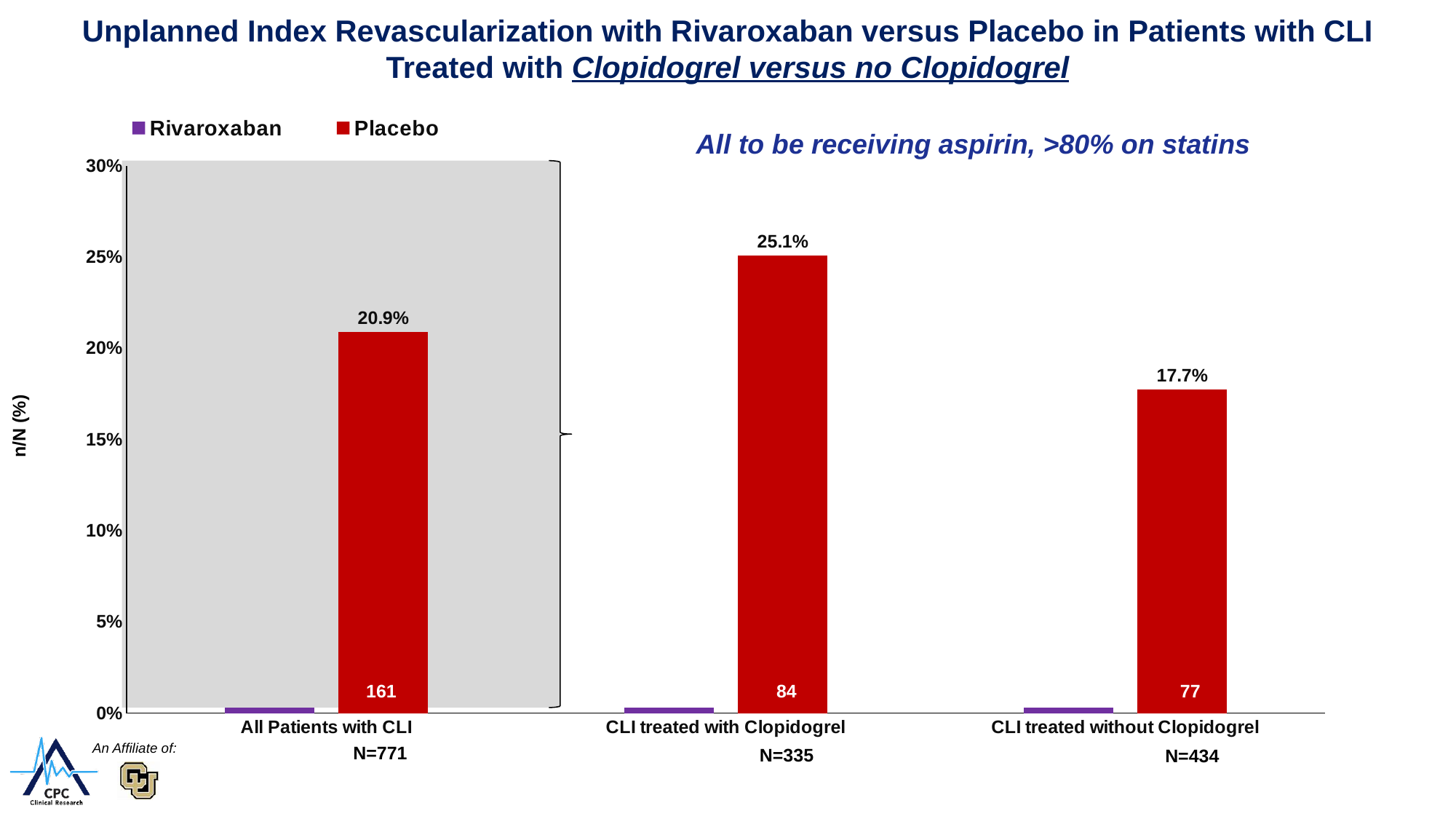
What is the Placebo value for All Patients with CLI? 20.9% What is the Placebo value for CLI treated with Clopidogrel? 25.1% What is the difference between the Placebo values for CLI treated with Clopidogrel and CLI treated without Clopidogrel? 7.4 percentage points What is the number of events (n) shown inside the Placebo bar for All Patients with CLI? 161 Which category has the lowest Placebo value? CLI treated without Clopidogrel Which category has the highest Placebo value? CLI treated with Clopidogrel How many categories are shown on the x axis? 3 What is the Placebo value for CLI treated without Clopidogrel? 17.7% What kind of chart is shown on the slide? bar chart How many series does the legend list? 2 Which is larger: the Placebo value for CLI treated with Clopidogrel or for All Patients with CLI? CLI treated with Clopidogrel